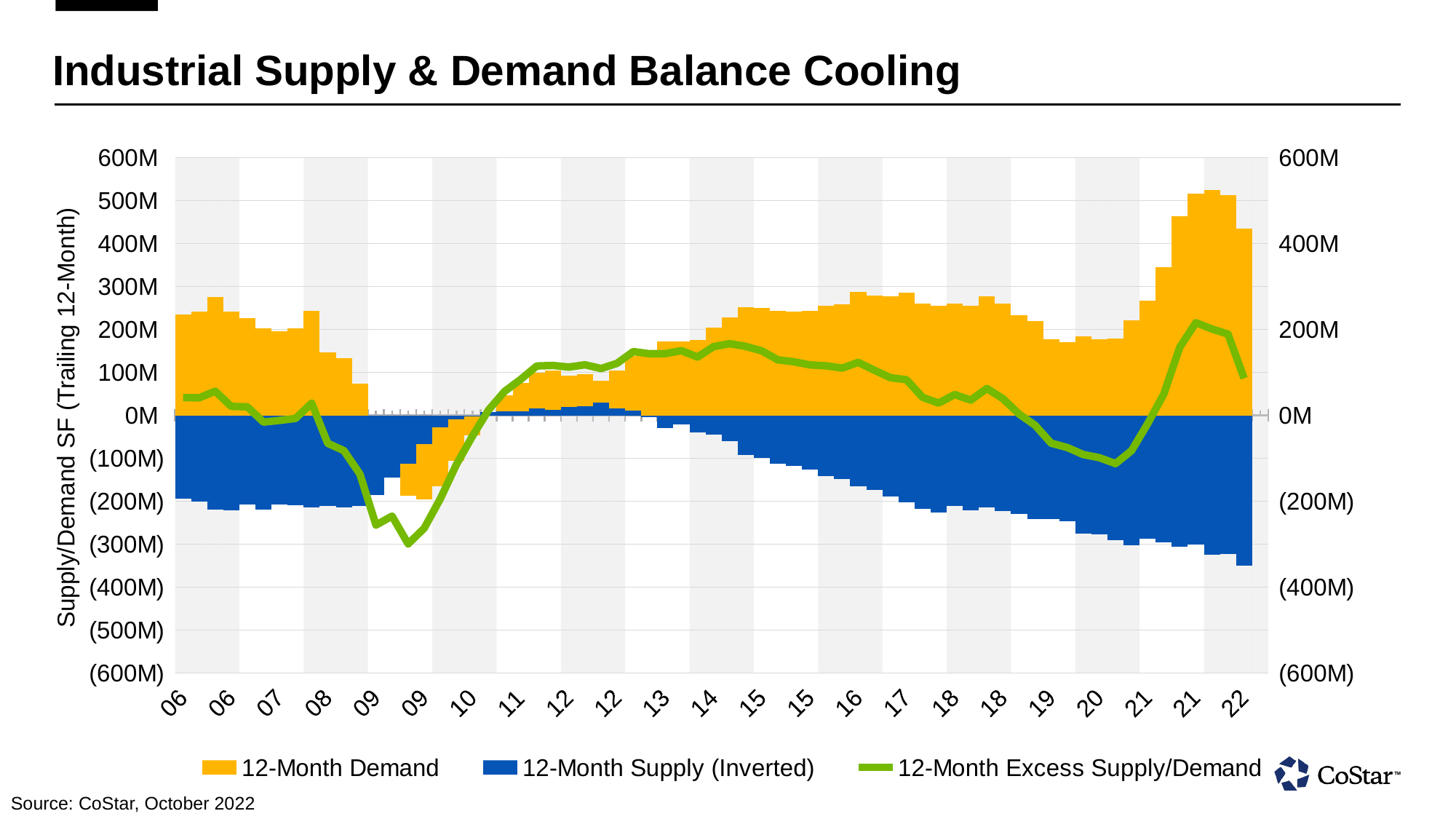
In which year does the 12-Month Excess Supply/Demand line reach its lowest value? 09 What is the title of the chart? Industrial Supply & Demand Balance Cooling What kind of chart is this? Combination bar and line chart Is the 12-Month Supply (Inverted) value at the end of 2022 greater or less than (300M)? less Is 12-Month Demand higher in 2021 or in 2016? 2021 Is the lowest point of the 12-Month Excess Supply/Demand line greater or less than (200M)? less Which series is drawn as a line rather than bars? 12-Month Excess Supply/Demand Does the 12-Month Excess Supply/Demand line rise or fall from 2009 to 2011? rise How many series does the legend list? 3 From 2021 to 2022, does 12-Month Demand rise or fall? fall Is the peak 12-Month Demand value in 2021 greater or less than 500M? greater